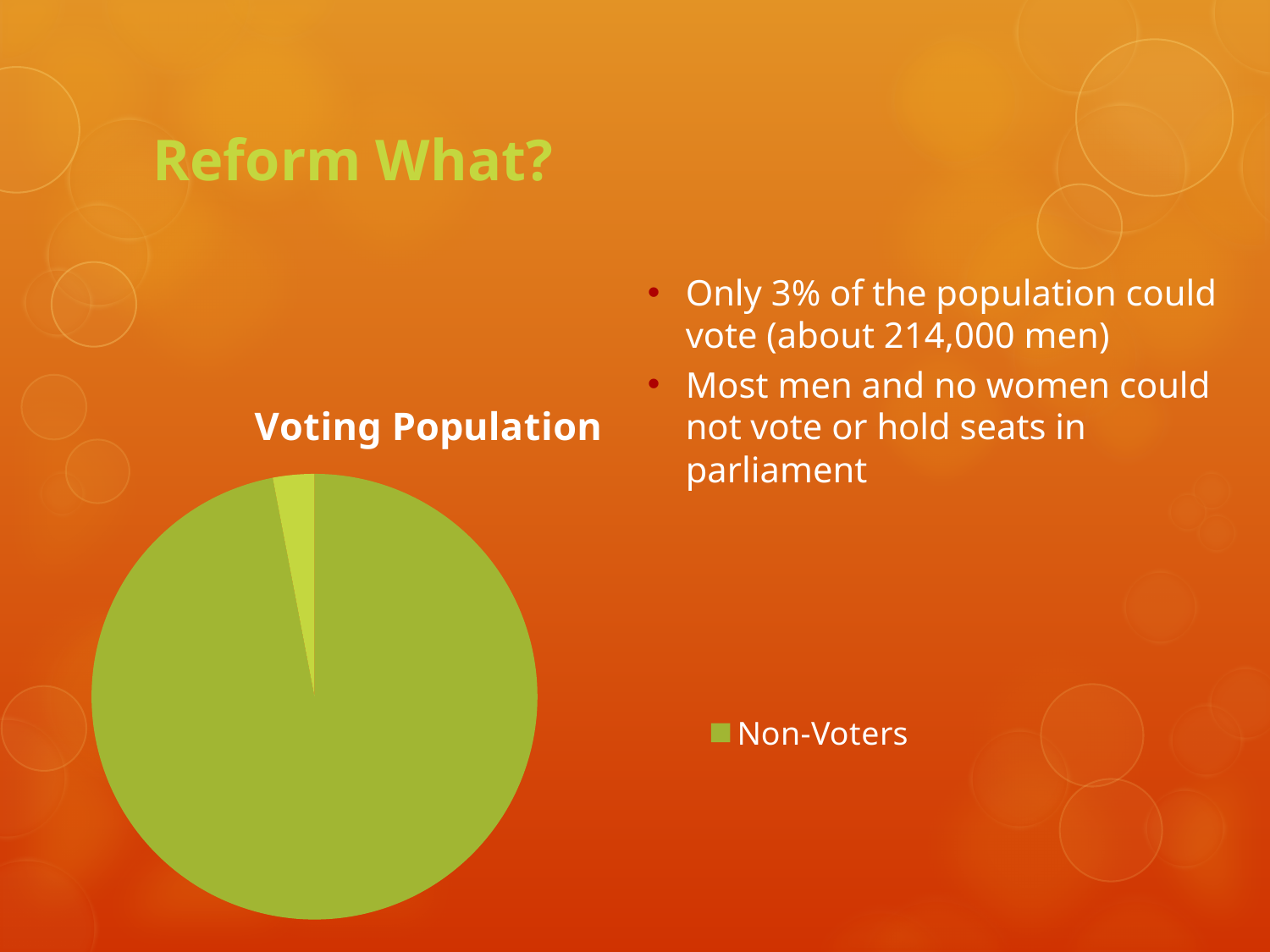
How many slices does the Voting Population pie chart have? 2 What is the title of the chart? Voting Population What kind of chart is shown on the slide? pie chart How many entries does the legend of the Voting Population chart list? 1 In the Voting Population pie chart, is the Non-Voters slice larger or smaller than the other slice? larger In the Voting Population pie chart, is the Non-Voters share greater or less than 50%? greater What entry does the legend of the Voting Population chart list? Non-Voters Which slice of the Voting Population pie chart is the largest? Non-Voters